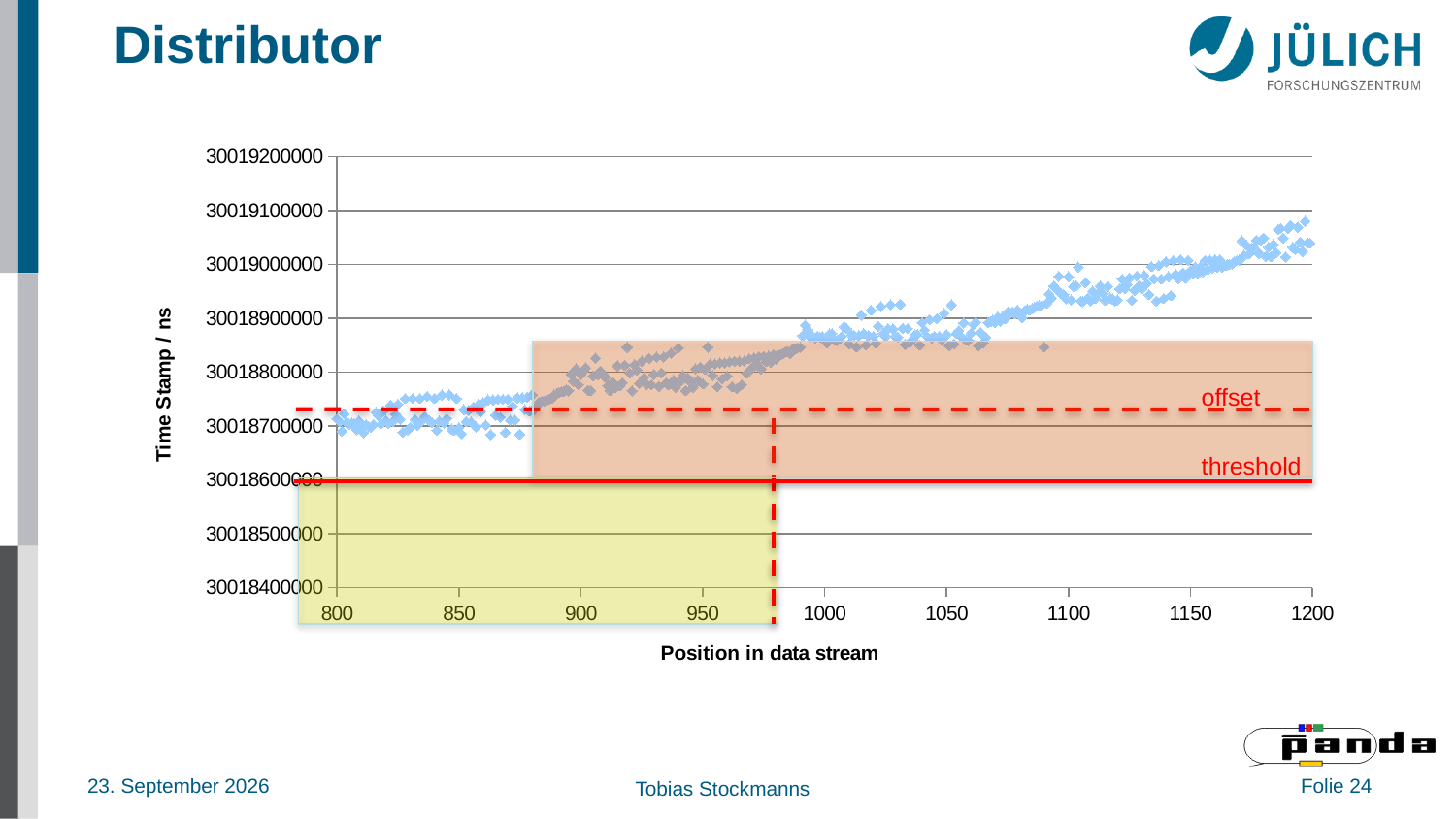
Is the time stamp value at position 1100 greater or less than 30018900000? greater At which y-axis value does the solid red line labelled 'threshold' lie? 30018600000 What is the title of the y axis? Time Stamp / ns Do the plotted time stamps rise or fall as the position in the data stream increases from 800 to 1200? rise Is the time stamp value at position 1000 greater or less than 30018800000? greater How many tick labels are shown on the x axis? 9 What kind of chart is shown on the slide? scatter chart What is the title of the x axis? Position in data stream Is the time stamp value at position 1200 greater or less than 30019000000? greater What is the highest value shown on the x axis? 1200 Which position has the larger time stamp value, 850 or 1150? 1150